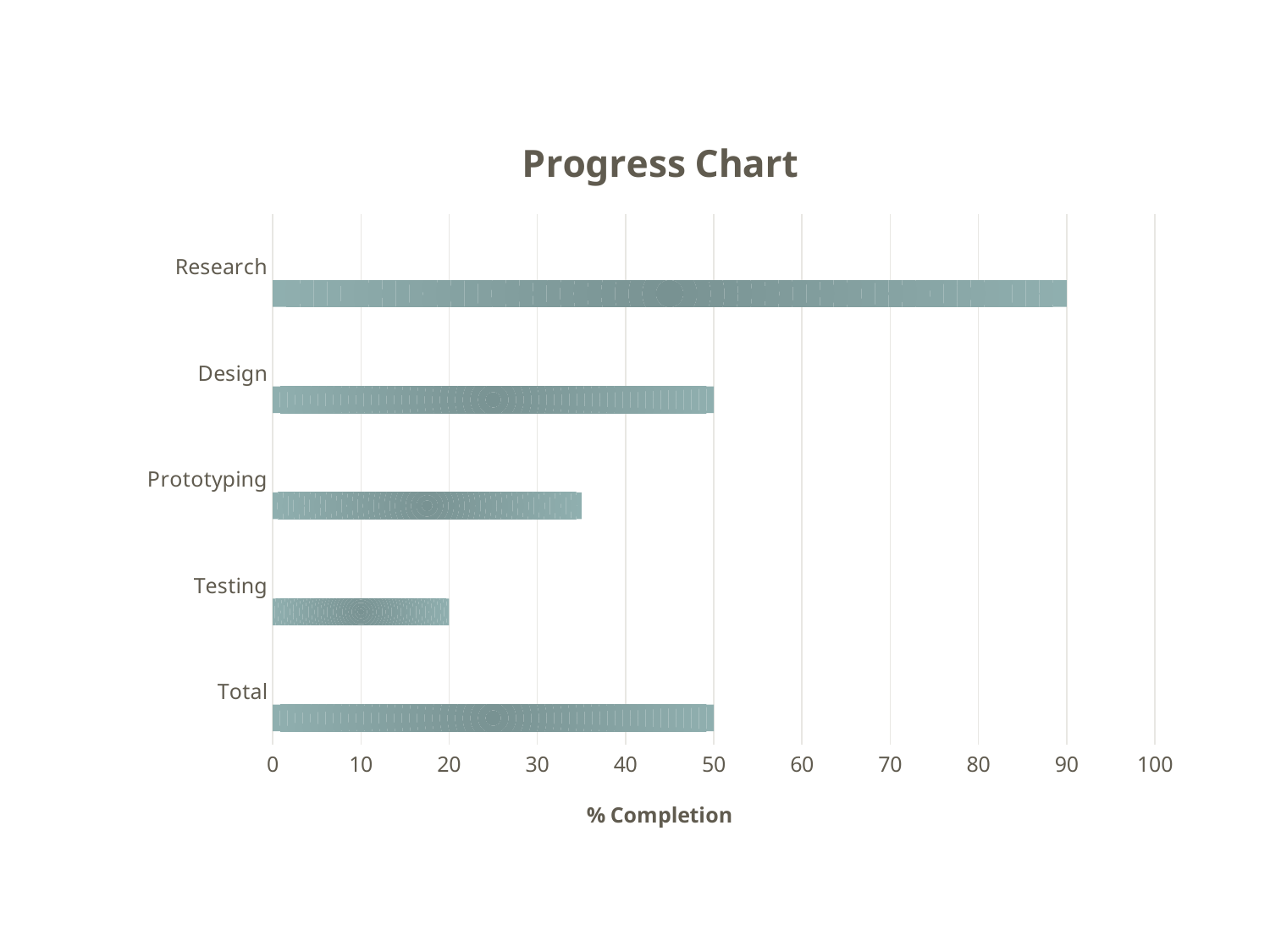
What is the x-axis label of the chart? % Completion How many categories are shown in the chart? 5 Is the value for Prototyping greater or less than 30? greater Which has a larger % Completion, Design or Prototyping? Design What is the % Completion value for Design? 50 What type of chart is shown on the slide? bar chart Which category has the highest % Completion? Research What is the % Completion value for Research? 90 What is the title of the chart? Progress Chart Which category has the lowest % Completion? Testing What is the difference in % Completion between Research and Testing? 70 What is the % Completion value for Testing? 20